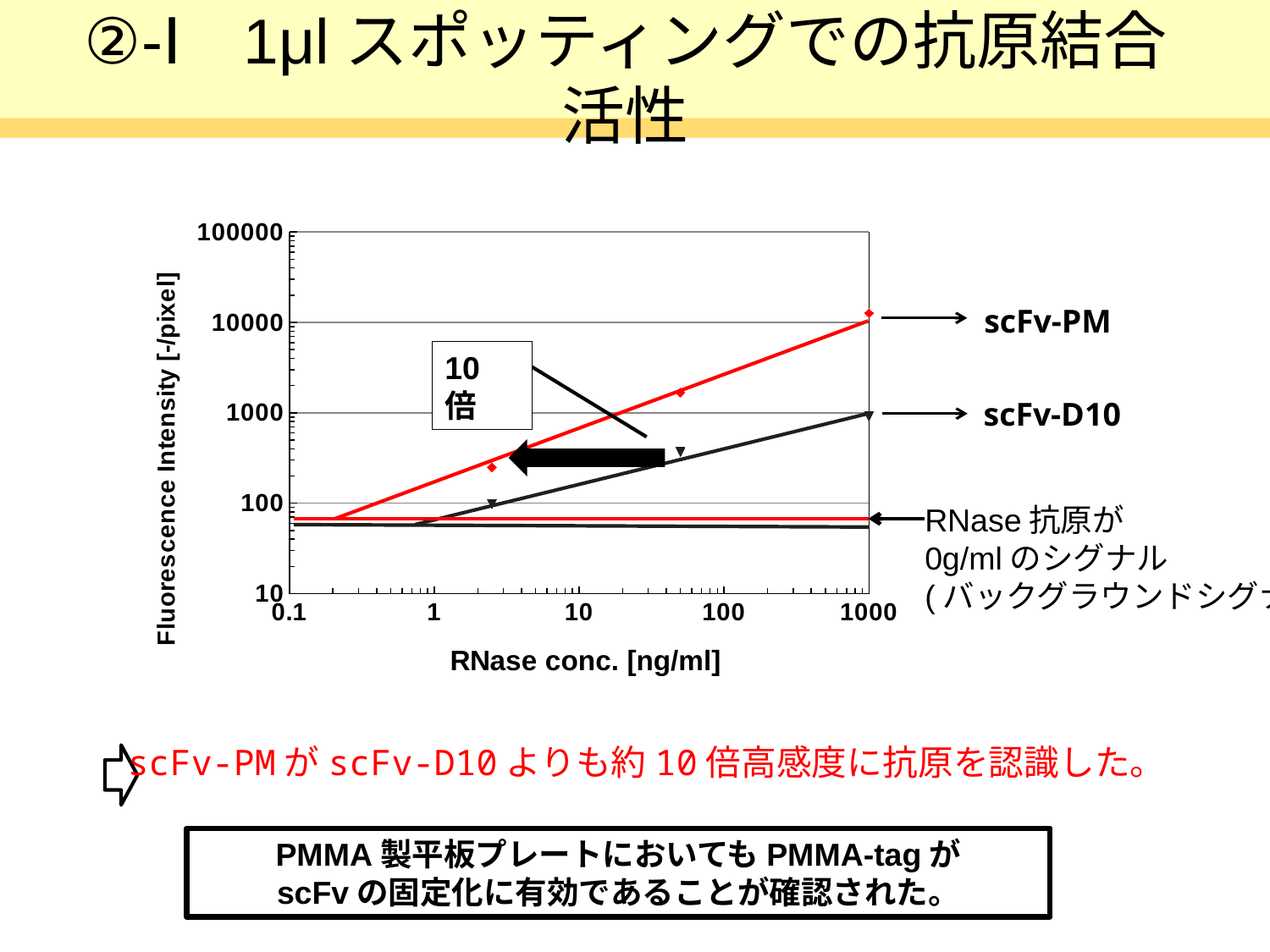
Which series is the highest across the plotted RNase concentrations? scFv-PM Is the fluorescence intensity of scFv-PM at 1000 ng/ml greater or less than 10000? greater Is the fluorescence intensity of scFv-D10 at 1000 ng/ml greater or less than 10000? less Is the fluorescence intensity of scFv-D10 at 50 ng/ml greater or less than 1000? less Which series has the higher fluorescence intensity at 1000 ng/ml RNase, scFv-PM or scFv-D10? scFv-PM What is the title of the y axis of the chart? Fluorescence Intensity [-/pixel] What is the title of the x axis of the chart? RNase conc. [ng/ml] How many series are labelled on the chart (excluding the background signal lines)? 2 What kind of chart is shown on the slide? line chart What is the lowest value shown on the y axis of the chart? 10 Does the fluorescence intensity of scFv-PM rise or fall as RNase concentration increases? rise